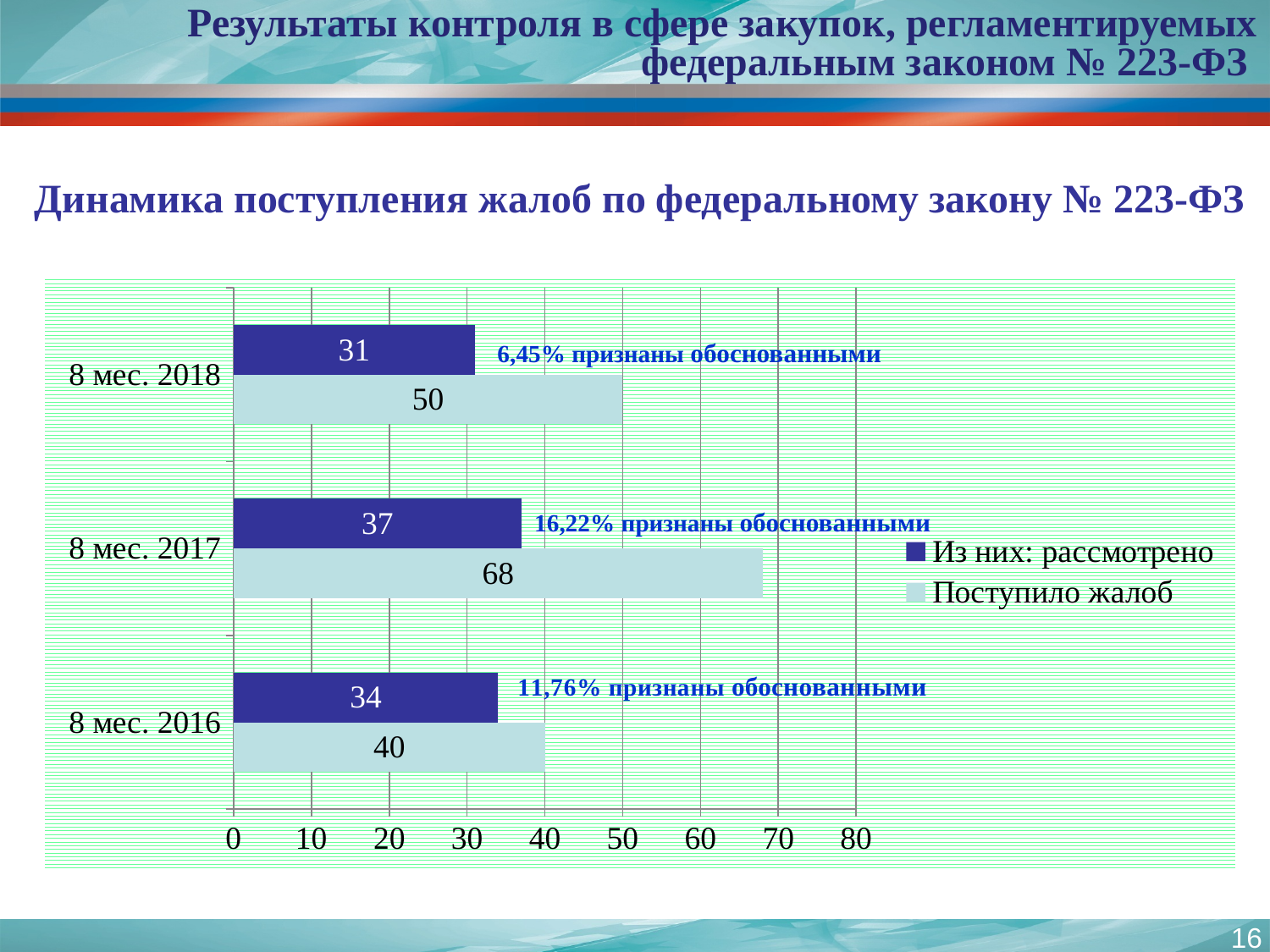
Is the value for "Поступило жалоб" in "8 мес. 2017" greater or less than 60? greater What value is shown for "Поступило жалоб" in "8 мес. 2016"? 40 How many series does the legend list? 2 Which is larger: "Поступило жалоб" in "8 мес. 2018" or in "8 мес. 2016"? 8 мес. 2018 Which period has the lowest value for "Из них: рассмотрено"? 8 мес. 2018 What percentage of complaints is annotated as "признаны обоснованными" for "8 мес. 2016"? 11,76% Which period has the highest value for "Поступило жалоб"? 8 мес. 2017 What is the difference between "Поступило жалоб" and "Из них: рассмотрено" in "8 мес. 2017"? 31 What value is shown for "Поступило жалоб" in "8 мес. 2017"? 68 What value is shown for "Из них: рассмотрено" in "8 мес. 2018"? 31 How many periods (categories) are shown on the chart? 3 What kind of chart is shown on the slide? bar chart